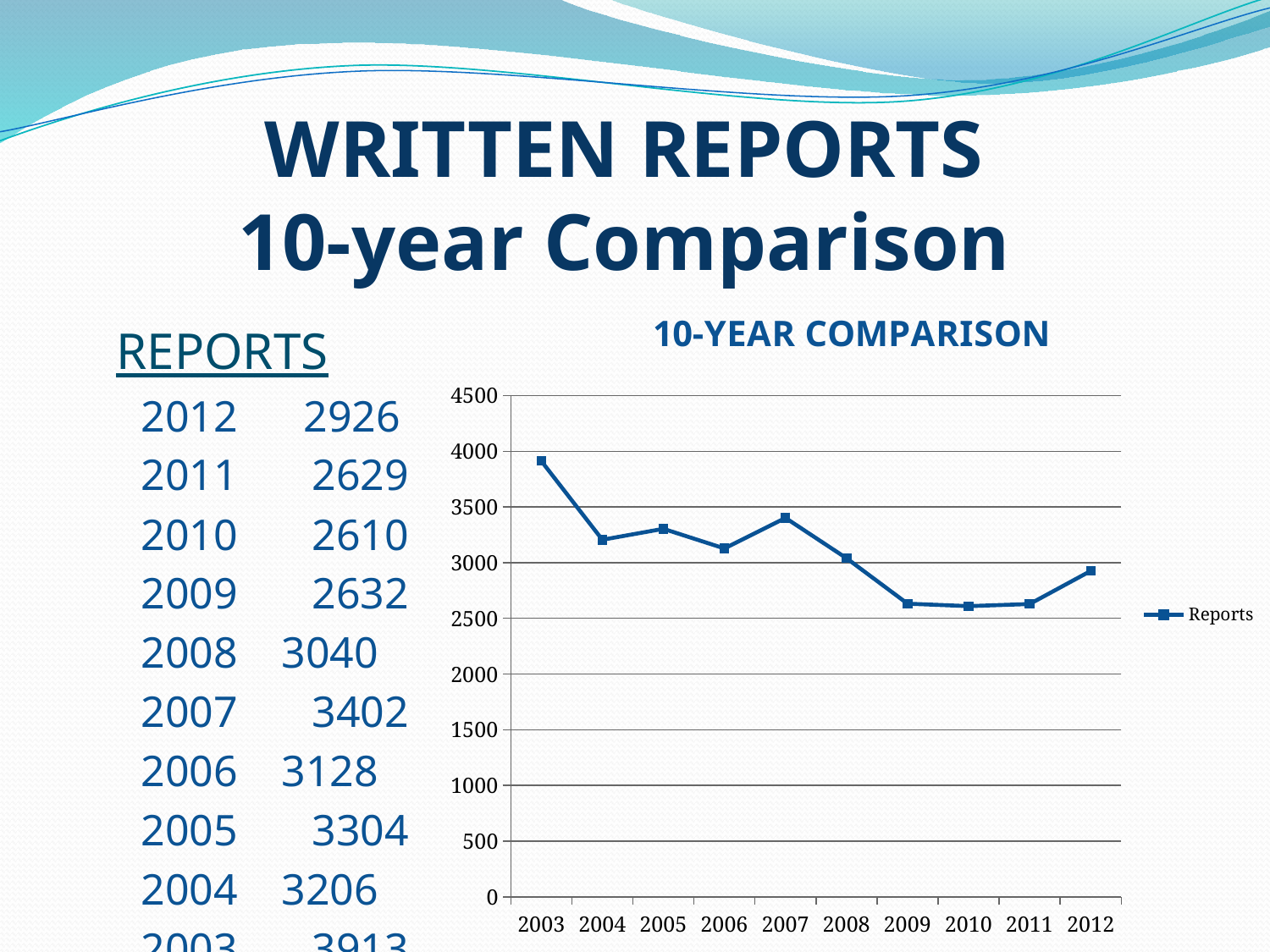
What is the chart's title? 10-YEAR COMPARISON Which year has the highest number of Reports? 2003 Which is larger, the Reports value for 2005 or for 2006? 2005 What is the value of Reports for 2010? 2610 What is the value of Reports for 2007? 3402 How many series does the legend list? 1 What is the difference between Reports in 2007 and 2008? 362 What kind of chart is shown on the slide? line chart Is the value for 2003 greater or less than 3500? greater What is the value of Reports for 2012? 2926 How many years are plotted on the x axis? 10 Which year has the lowest number of Reports? 2010